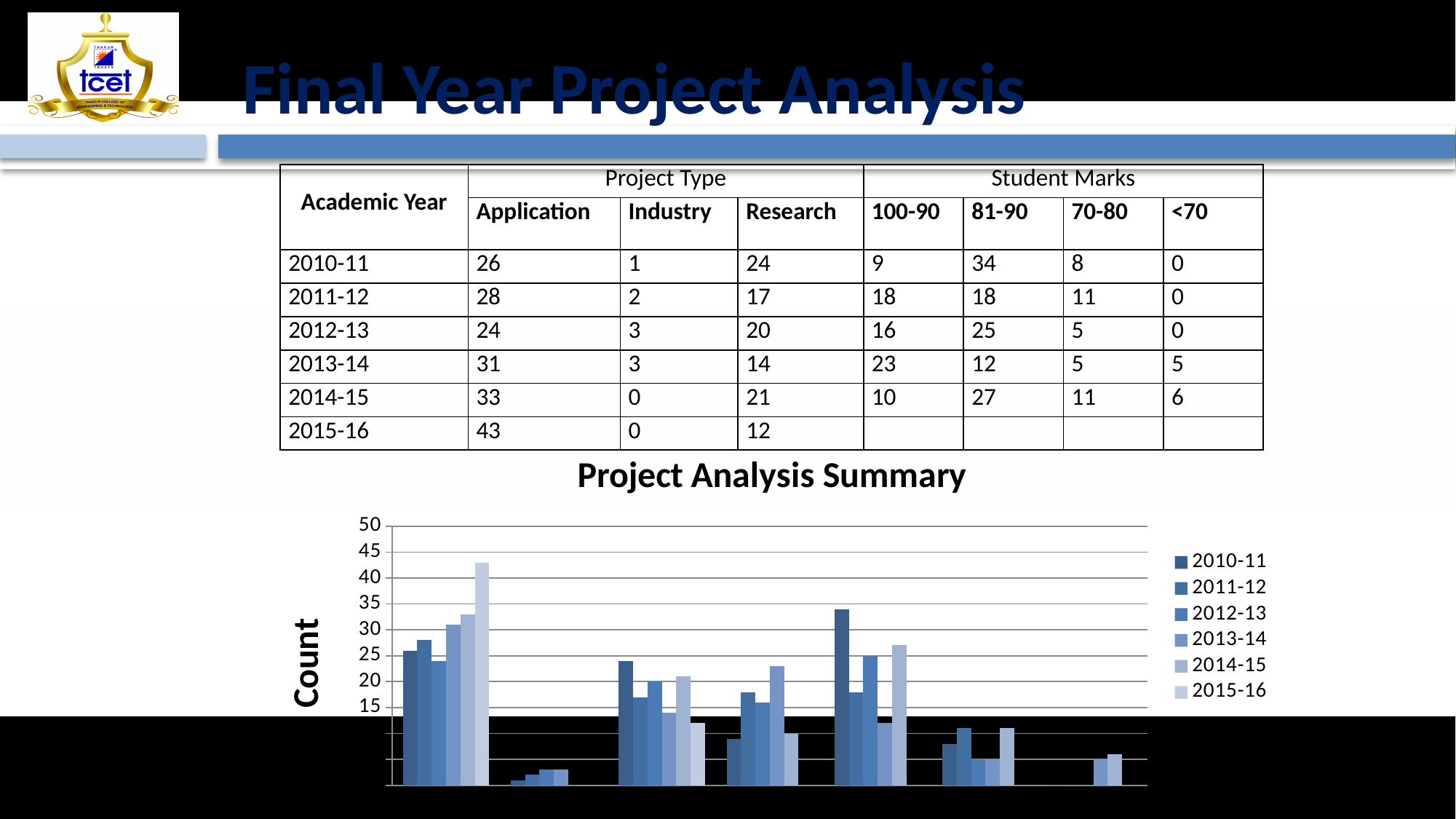
How many series does the legend of the Project Analysis Summary chart list? 6 How many groups of bars are shown in the Project Analysis Summary chart? 7 In the Project Analysis Summary chart, which series has the tallest bar in the first group of bars? 2015-16 In the Project Analysis Summary chart, is the 2013-14 bar in the third group of bars greater or less than 20? less In the Project Analysis Summary chart, is the 2010-11 bar in the fourth group of bars greater or less than 30? less What is the title of the chart on the slide? Project Analysis Summary In the Project Analysis Summary chart, is the 2010-11 bar in the first group of bars greater or less than 30? less What kind of chart is the Project Analysis Summary chart? bar chart What is the label on the vertical axis of the Project Analysis Summary chart? Count In the Project Analysis Summary chart, which series has the tallest bar in the fourth group of bars? 2013-14 In the Project Analysis Summary chart, which is taller in the first group of bars: the 2013-14 bar or the 2012-13 bar? 2013-14